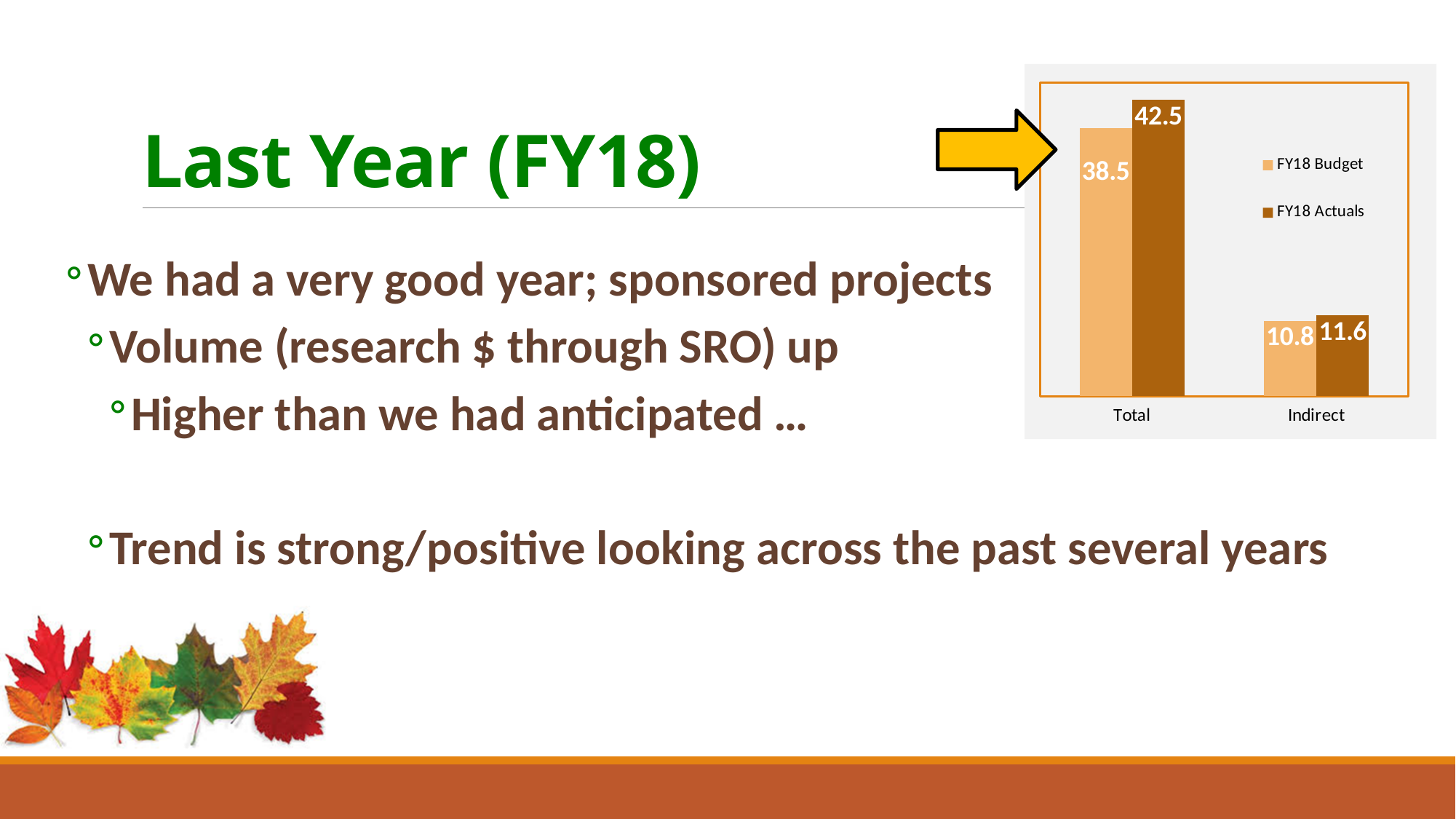
How many series does the chart legend list? 2 What is the difference between FY18 Actuals and FY18 Budget for Indirect? 0.8 For Total, which is larger: FY18 Budget or FY18 Actuals? FY18 Actuals What is the FY18 Actuals value for Total? 42.5 What is the FY18 Budget value for Indirect? 10.8 What kind of chart is shown on the slide? Bar chart Which category has the lowest FY18 Budget value? Indirect What is the FY18 Budget value for Total? 38.5 Which category has the highest FY18 Actuals value? Total How many categories are shown on the x axis of the chart? 2 What is the difference between FY18 Actuals and FY18 Budget for Total? 4.0 What is the FY18 Actuals value for Indirect? 11.6